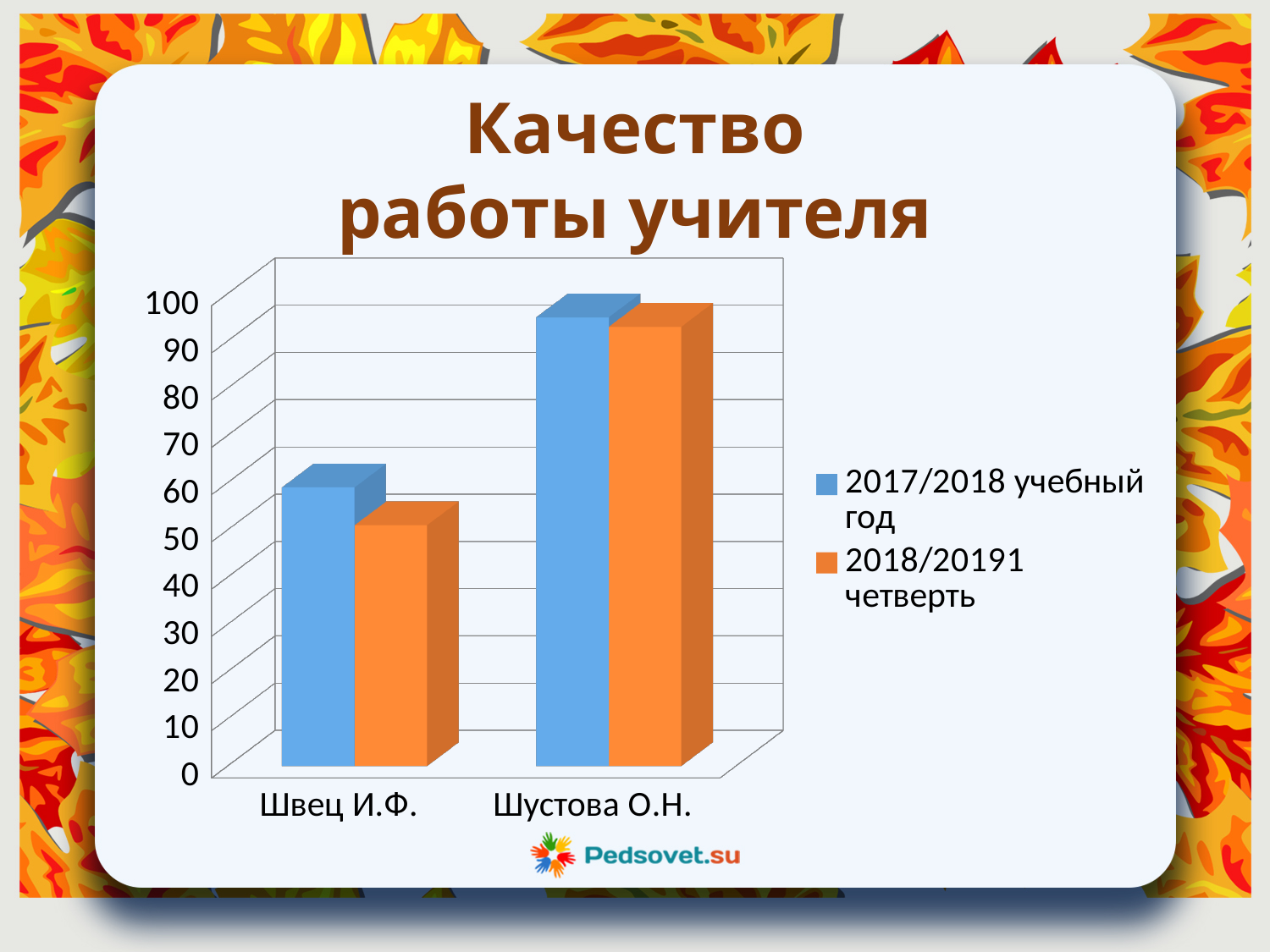
How many series does the legend list? 2 Is the value for Швец И.Ф. in the 2017/2018 учебный год series greater or less than 50? greater Is the value for Швец И.Ф. in the 2018/20191 четверть series greater or less than 60? less What is the title of the chart? Качество работы учителя Which teacher has the higher value in the 2018/20191 четверть series? Шустова О.Н. How many categories are shown on the x axis? 2 Is the value for Шустова О.Н. in the 2017/2018 учебный год series greater or less than 90? greater Which series is shown in orange? 2018/20191 четверть For Швец И.Ф., which series has the larger value: 2017/2018 учебный год or 2018/20191 четверть? 2017/2018 учебный год Which teacher has the lowest value in the 2017/2018 учебный год series? Швец И.Ф. What kind of chart is shown on the slide? bar chart